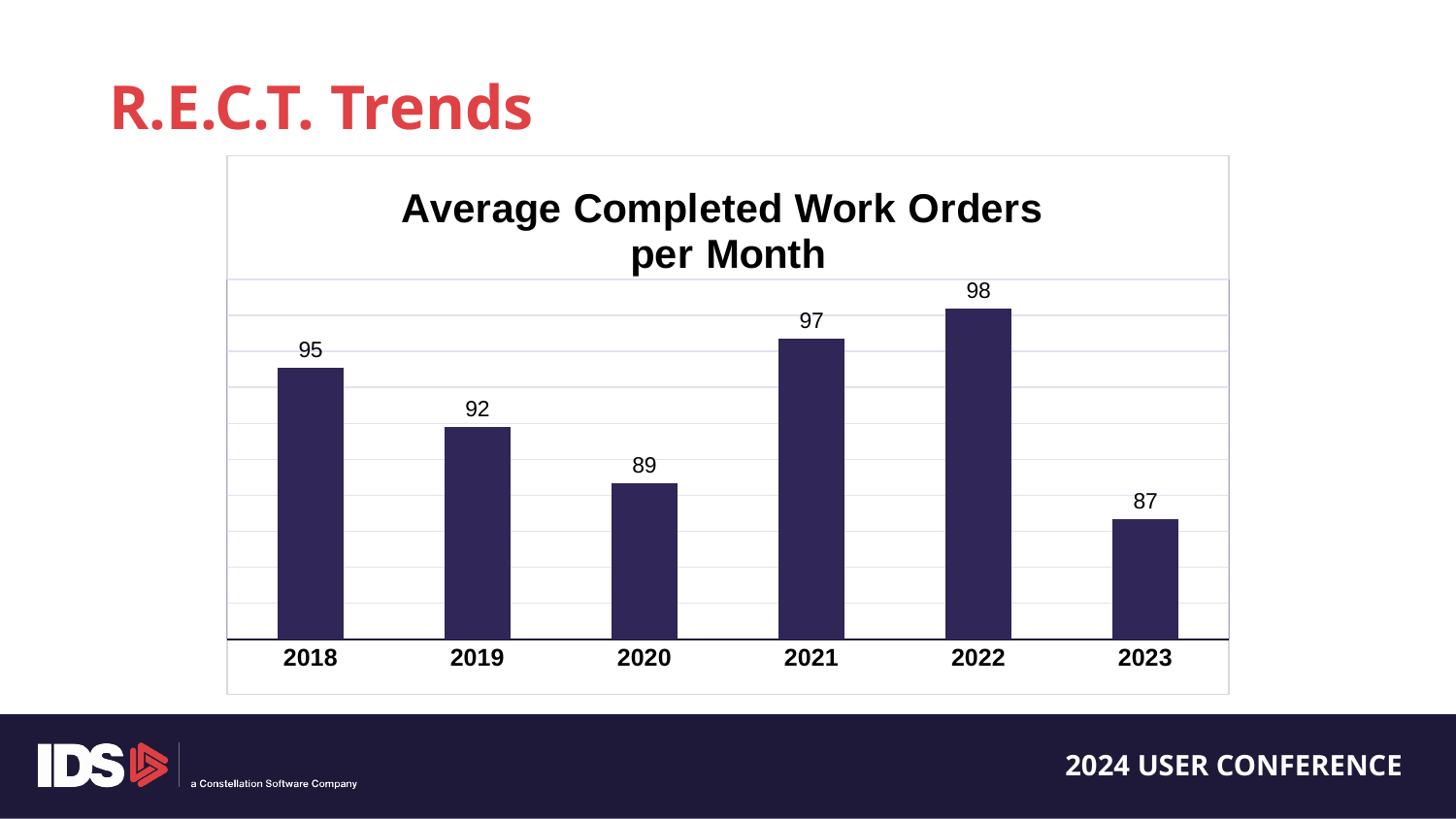
What is the difference between the values for 2022 and 2023? 11 Which year has the highest average completed work orders per month? 2022 What is the difference between the values for 2021 and 2020? 8 What is the value shown for 2023? 87 Which year has a larger value, 2019 or 2021? 2021 What is the value shown for 2020? 89 What is the title of the chart? Average Completed Work Orders per Month What is the average completed work orders per month for 2018? 95 How many years are shown on the x axis of the chart? 6 Do the values rise or fall from 2018 to 2020? Fall What kind of chart is shown on the slide? Bar chart Which year has the lowest average completed work orders per month? 2023